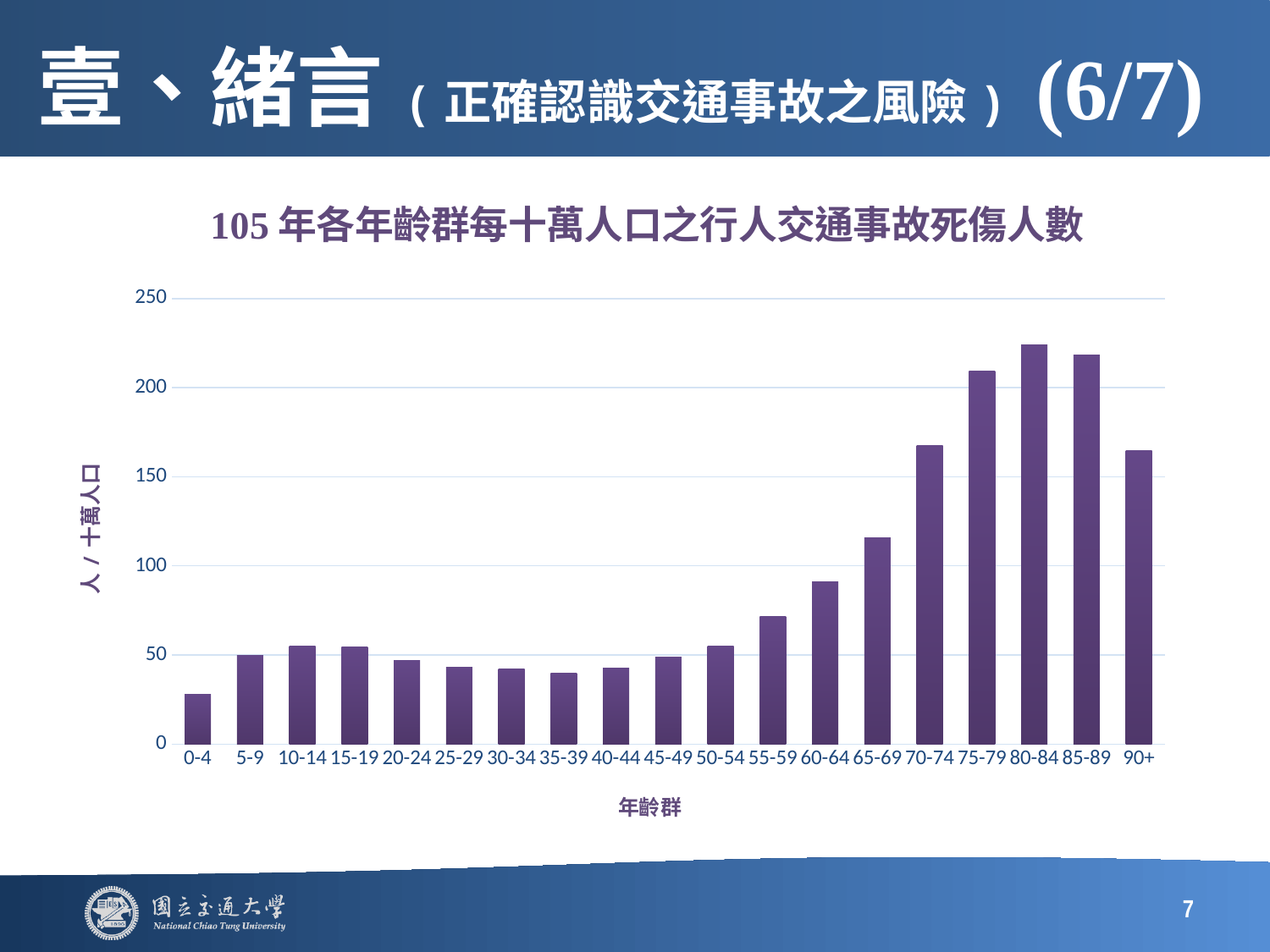
Is the value for the 70-74 age group greater or less than 150? greater What kind of chart is shown on the slide? bar chart From the 40-44 age group to the 80-84 age group, do the values rise or fall? rise Which has the larger value, the 60-64 age group or the 50-54 age group? 60-64 Is the value for the 65-69 age group greater or less than 100? greater What is the label on the x axis of the chart? 年齡群 Is the value for the 60-64 age group greater or less than 100? less Which age group has the lowest value in the chart? 0-4 How many age groups are shown on the x axis of the chart? 19